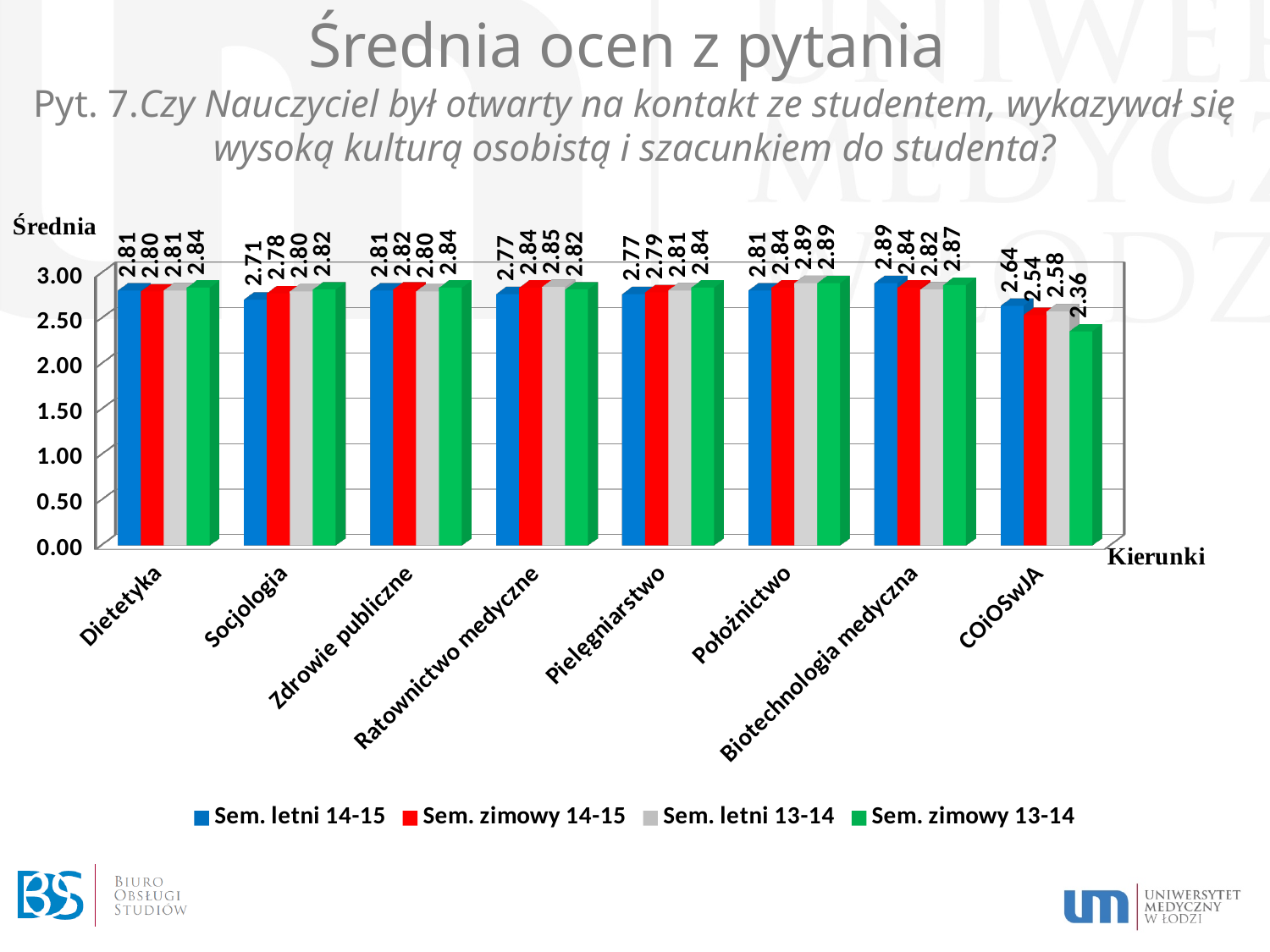
What is the value for Socjologia in the Sem. letni 14-15 series? 2.71 What is the value for COiOSwJA in the Sem. zimowy 13-14 series? 2.36 Is the value for COiOSwJA in the Sem. zimowy 13-14 series greater or less than 2.50? less What is the value for Położnictwo in the Sem. letni 13-14 series? 2.89 How many categories (kierunki) are shown on the x axis? 8 Which category has the highest value in the Sem. letni 14-15 series? Biotechnologia medyczna What is the difference between the Sem. letni 14-15 and Sem. zimowy 13-14 values for COiOSwJA? 0.28 How many series does the legend list? 4 Which is larger for Socjologia: the Sem. letni 14-15 value or the Sem. zimowy 13-14 value? Sem. zimowy 13-14 Which category has the lowest value in the Sem. letni 14-15 series? COiOSwJA What kind of chart is shown on the slide? bar chart What is the value for Ratownictwo medyczne in the Sem. zimowy 14-15 series? 2.84